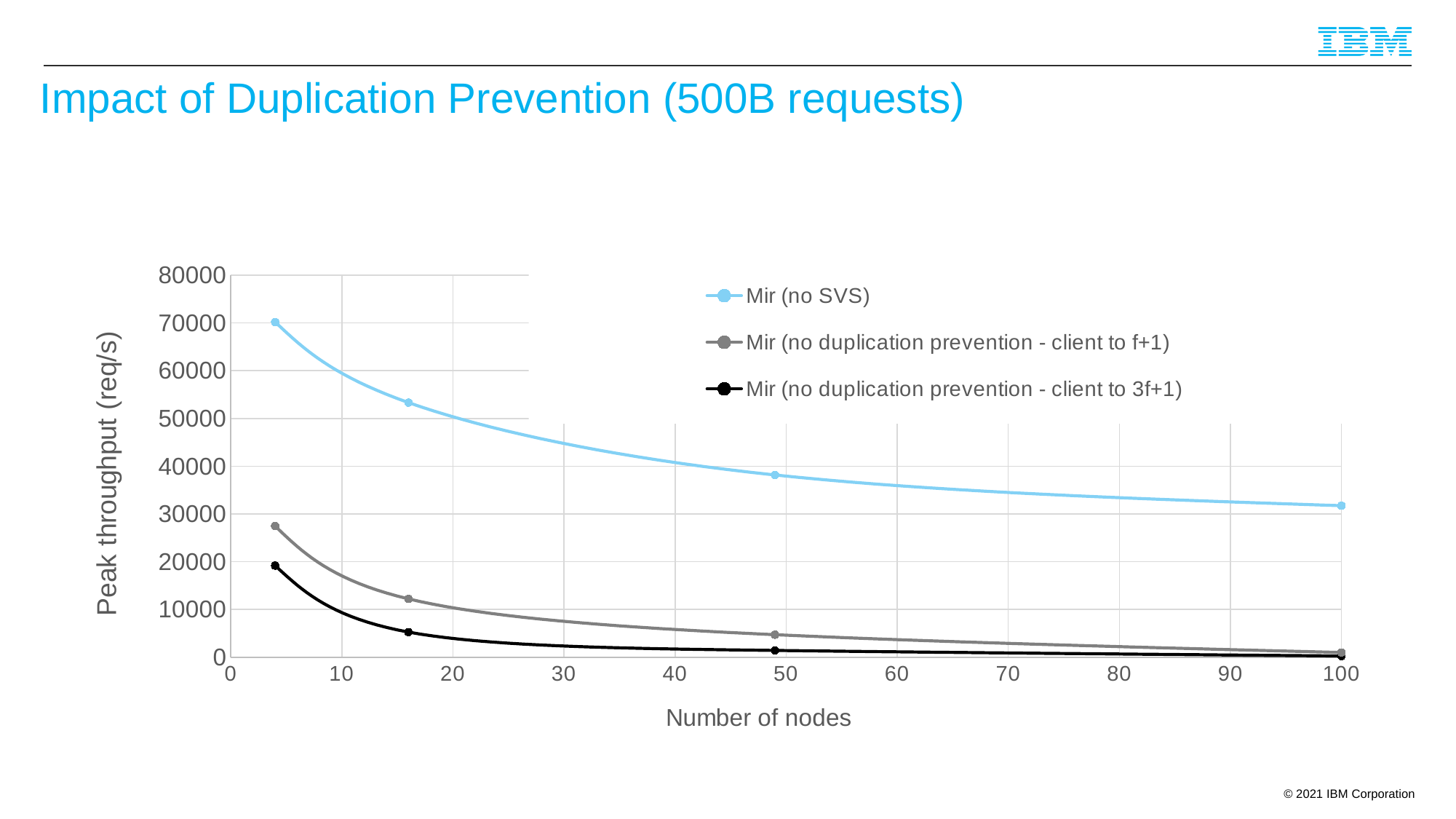
Does peak throughput rise or fall as the number of nodes increases for the Mir (no SVS) series? Fall How many data points are plotted for the Mir (no SVS) series? 4 Is the peak throughput for Mir (no duplication prevention - client to 3f+1) at 16 nodes greater or less than 10000? less How many series does the legend list? 3 At 100 nodes, which series has the larger peak throughput: Mir (no SVS) or Mir (no duplication prevention - client to f+1)? Mir (no SVS) Is the peak throughput for Mir (no duplication prevention - client to f+1) at 4 nodes greater or less than 30000? less What kind of chart is shown on the slide? Line chart What is the label of the x axis? Number of nodes Which series has the lowest peak throughput across all node counts? Mir (no duplication prevention - client to 3f+1) Which series has the highest peak throughput across all node counts? Mir (no SVS) Is the peak throughput for Mir (no SVS) at 4 nodes greater or less than 60000? greater